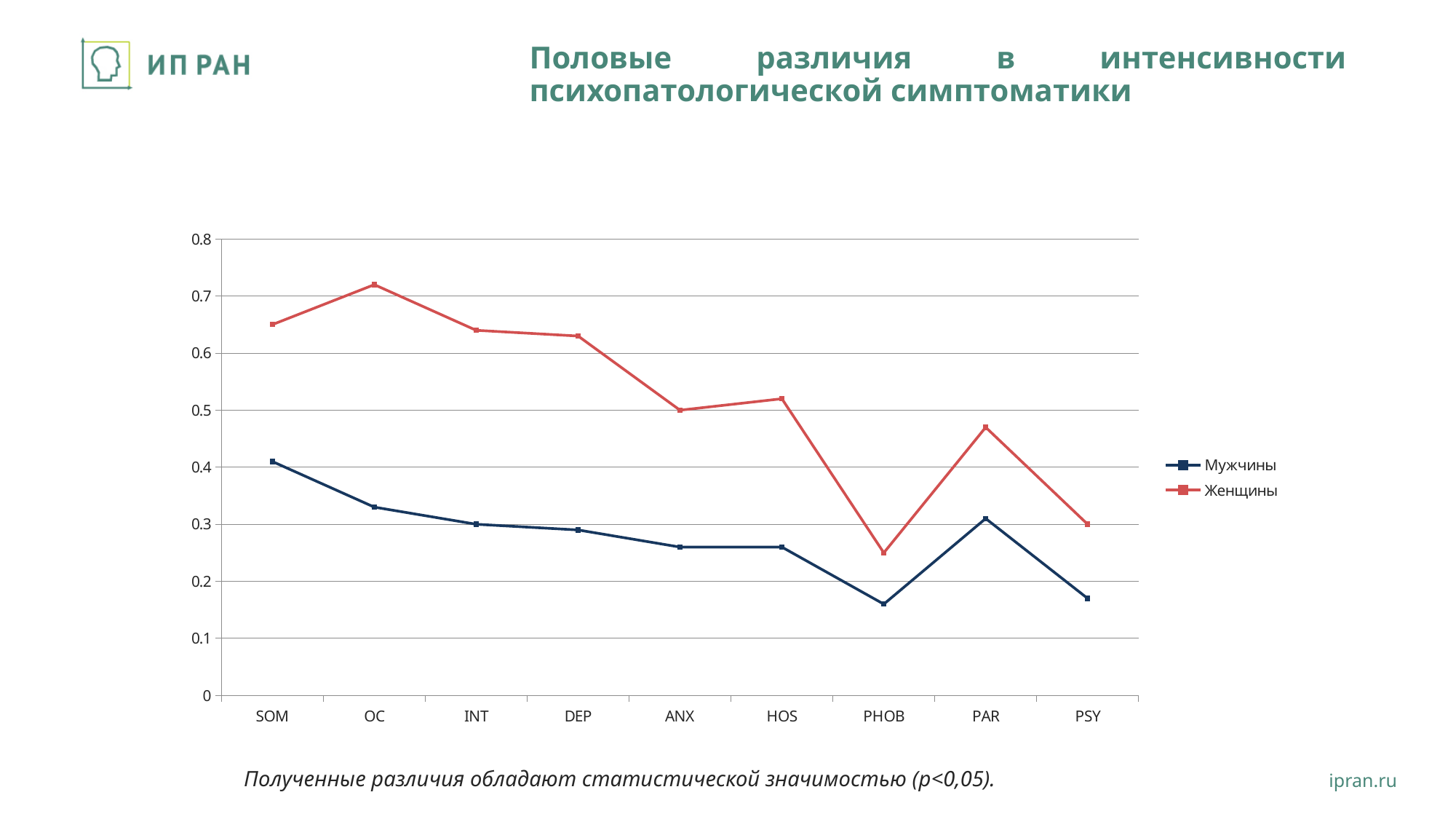
What kind of chart is shown on the slide? line chart Which category has the highest value for Мужчины? SOM Is the value for Мужчины at PHOB greater or less than 0.2? less Is the value for Женщины at PHOB greater or less than 0.3? less How many categories are shown on the x axis? 9 How many series does the legend list? 2 Which category has the lowest value for Мужчины? PHOB Is the value for Женщины at SOM greater or less than 0.6? greater Does the Мужчины line rise or fall from SOM to PHOB? fall Which category has the highest value for Женщины? OC At SOM, which series has the larger value, Мужчины or Женщины? Женщины Which category has the lowest value for Женщины? PHOB